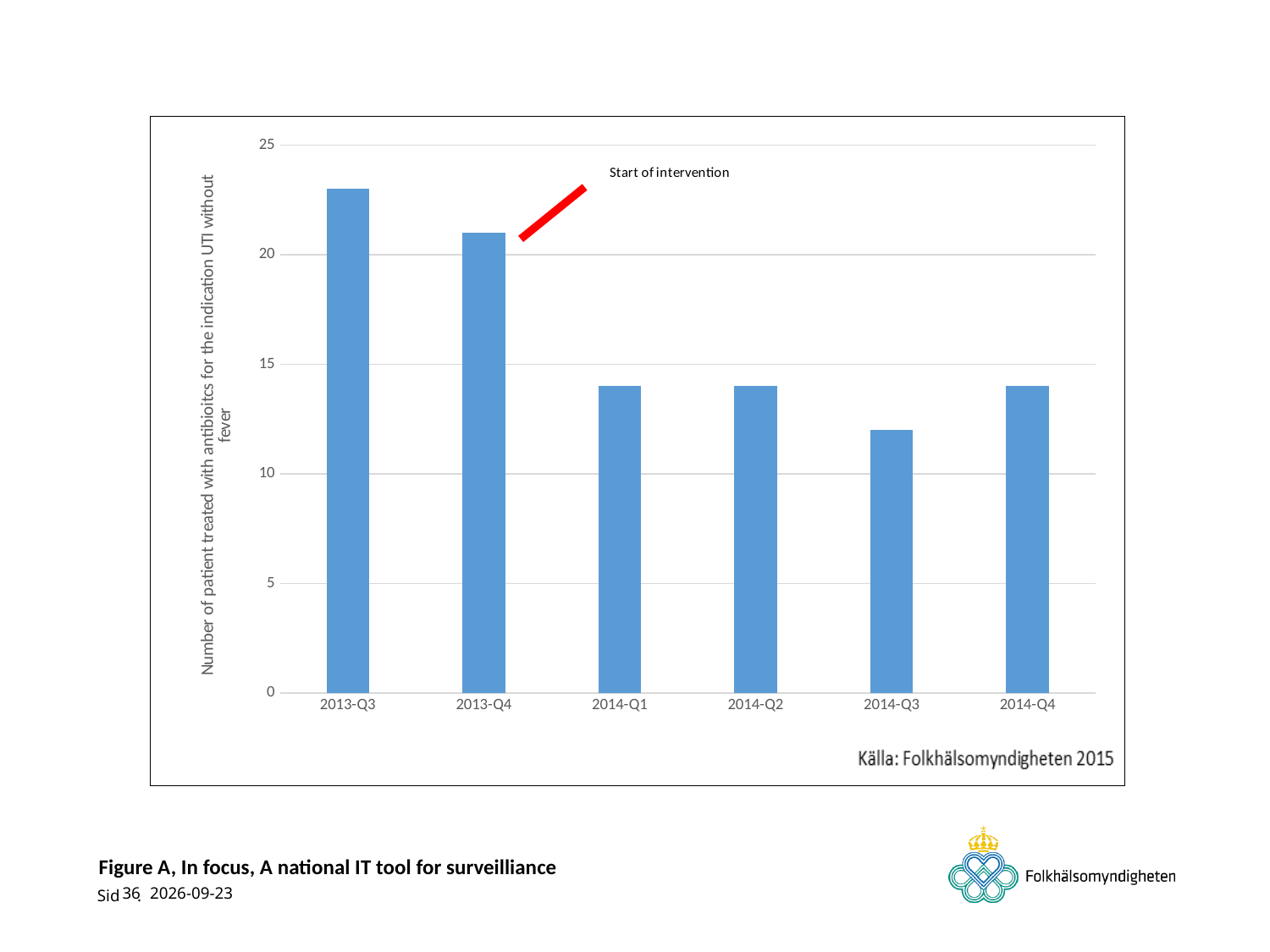
What does the red arrow annotation on the chart mark? Start of intervention Do the values generally rise or fall from 2013-Q3 to 2014-Q4? fall Which quarter has the lowest number of patients treated with antibiotics for UTI without fever? 2014-Q3 Which is larger, the value for 2013-Q3 or the value for 2014-Q1? 2013-Q3 How many quarters are shown on the x axis of the chart? 6 Is the value for 2013-Q3 greater or less than 20? greater What kind of chart is shown on the slide? bar chart Is the value for 2014-Q1 greater or less than 15? less Is the value for 2014-Q3 greater or less than 10? greater Which quarter has the highest number of patients treated with antibiotics for UTI without fever? 2013-Q3 Which is larger, the value for 2014-Q3 or the value for 2013-Q4? 2013-Q4